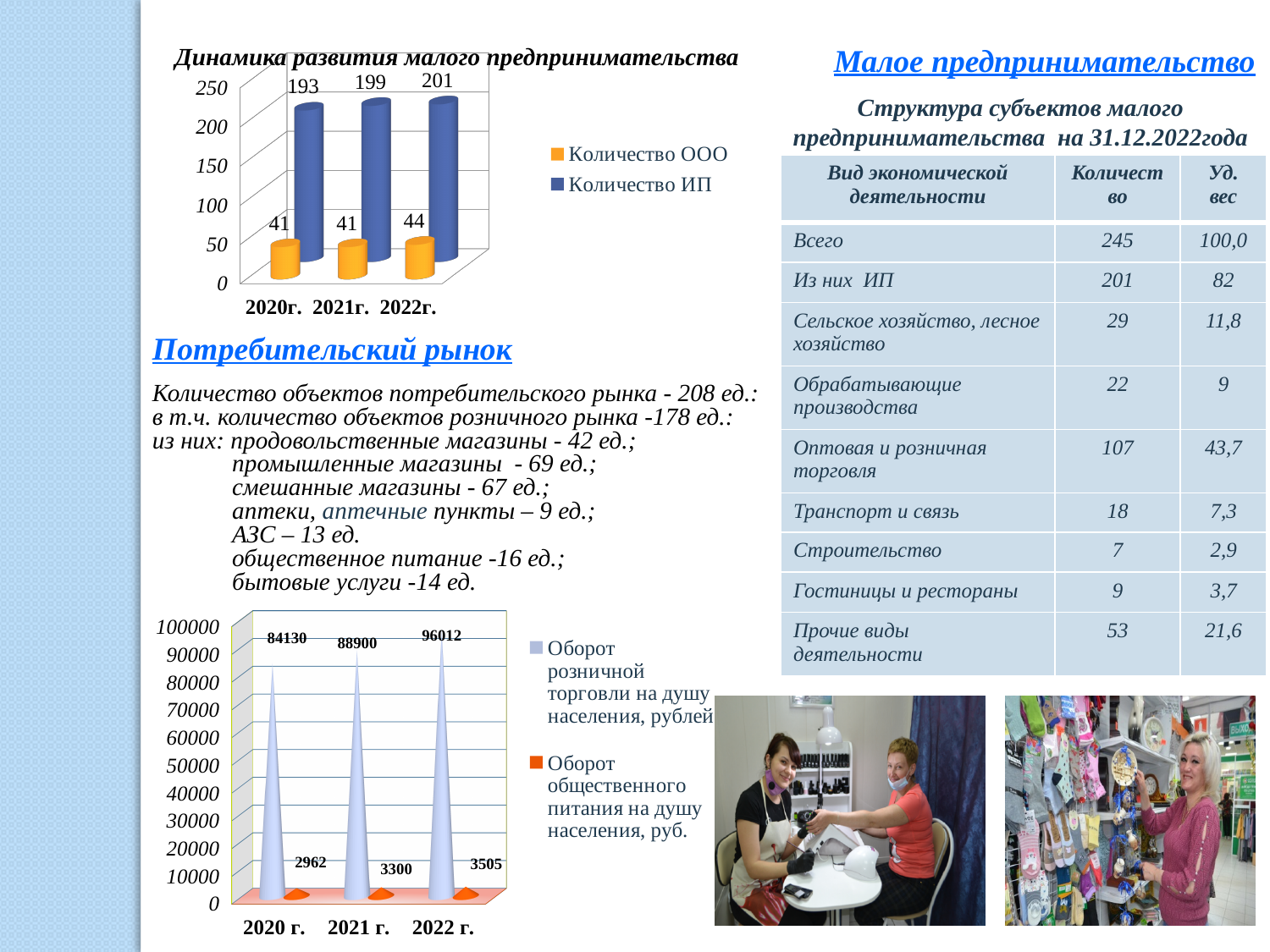
In the chart 'Динамика развития малого предпринимательства', does 'Количество ИП' rise or fall from 2020г. to 2022г.? Rise In the bottom-left chart, which year has the lowest value for 'Оборот общественного питания на душу населения, руб.'? 2020 г. In the chart 'Динамика развития малого предпринимательства', what is the value of 'Количество ИП' for 2022г.? 201 In the chart 'Динамика развития малого предпринимательства', how many series does the legend list? 2 In the bottom-left chart, how many years are shown on the x axis? 3 In the chart 'Динамика развития малого предпринимательства', what is the value of 'Количество ООО' for 2020г.? 41 In the bottom-left chart, what is the value of 'Оборот розничной торговли на душу населения, рублей' for 2021 г.? 88900 In the chart 'Динамика развития малого предпринимательства', which year has the highest value for 'Количество ООО'? 2022г. What type of chart is 'Динамика развития малого предпринимательства'? Bar chart In the bottom-left chart, what is the value of 'Оборот общественного питания на душу населения, руб.' for 2022 г.? 3505 In the bottom-left chart, what is the difference between the retail turnover per capita in 2022 г. and 2020 г.? 11882 In the chart 'Динамика развития малого предпринимательства', by how much did 'Количество ИП' increase from 2020г. to 2022г.? 8